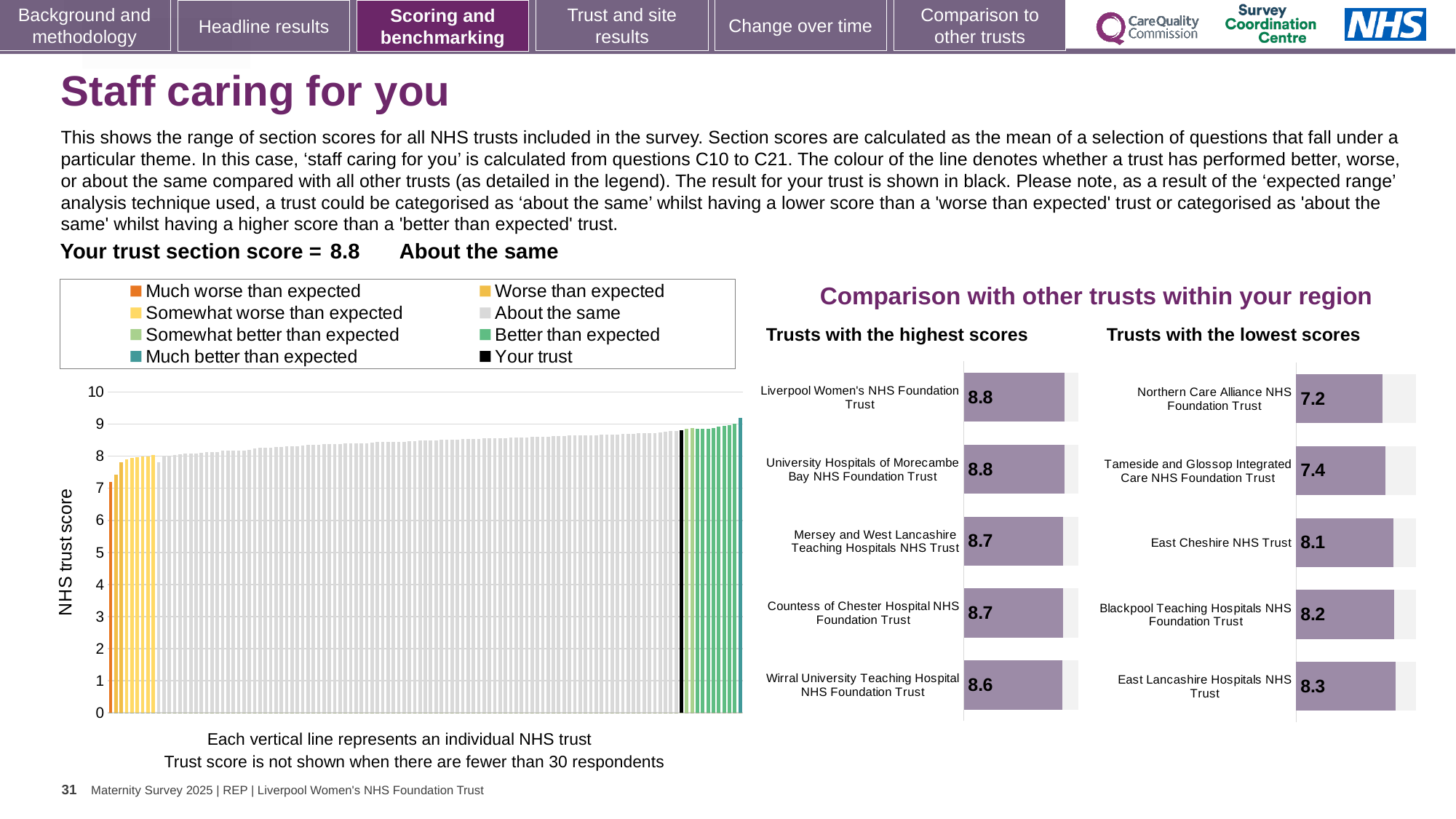
In the large chart on the left, is the value for the leftmost orange bar greater or less than 8? less What kind of chart is the large chart on the left showing NHS trust scores? bar chart In the 'Trusts with the lowest scores' chart, which has the higher score: East Cheshire NHS Trust or Tameside and Glossop Integrated Care NHS Foundation Trust? East Cheshire NHS Trust In the large chart on the left, is the value for the black 'Your trust' bar greater or less than 8? greater In the 'Trusts with the lowest scores' chart, which trust has the lowest score? Northern Care Alliance NHS Foundation Trust In the 'Trusts with the lowest scores' chart, what is the score for Tameside and Glossop Integrated Care NHS Foundation Trust? 7.4 In the 'Trusts with the highest scores' chart, how many trusts are shown? 5 In the large chart on the left, do the trust scores rise or fall from left to right? rise In the 'Trusts with the highest scores' chart, which trust has the lowest score? Wirral University Teaching Hospital NHS Foundation Trust In the large chart on the left, how many entries does the legend list? 8 In the 'Trusts with the highest scores' chart, what is the score for Wirral University Teaching Hospital NHS Foundation Trust? 8.6 In the 'Trusts with the lowest scores' chart, what is the difference between the scores of East Lancashire Hospitals NHS Trust and Northern Care Alliance NHS Foundation Trust? 1.1